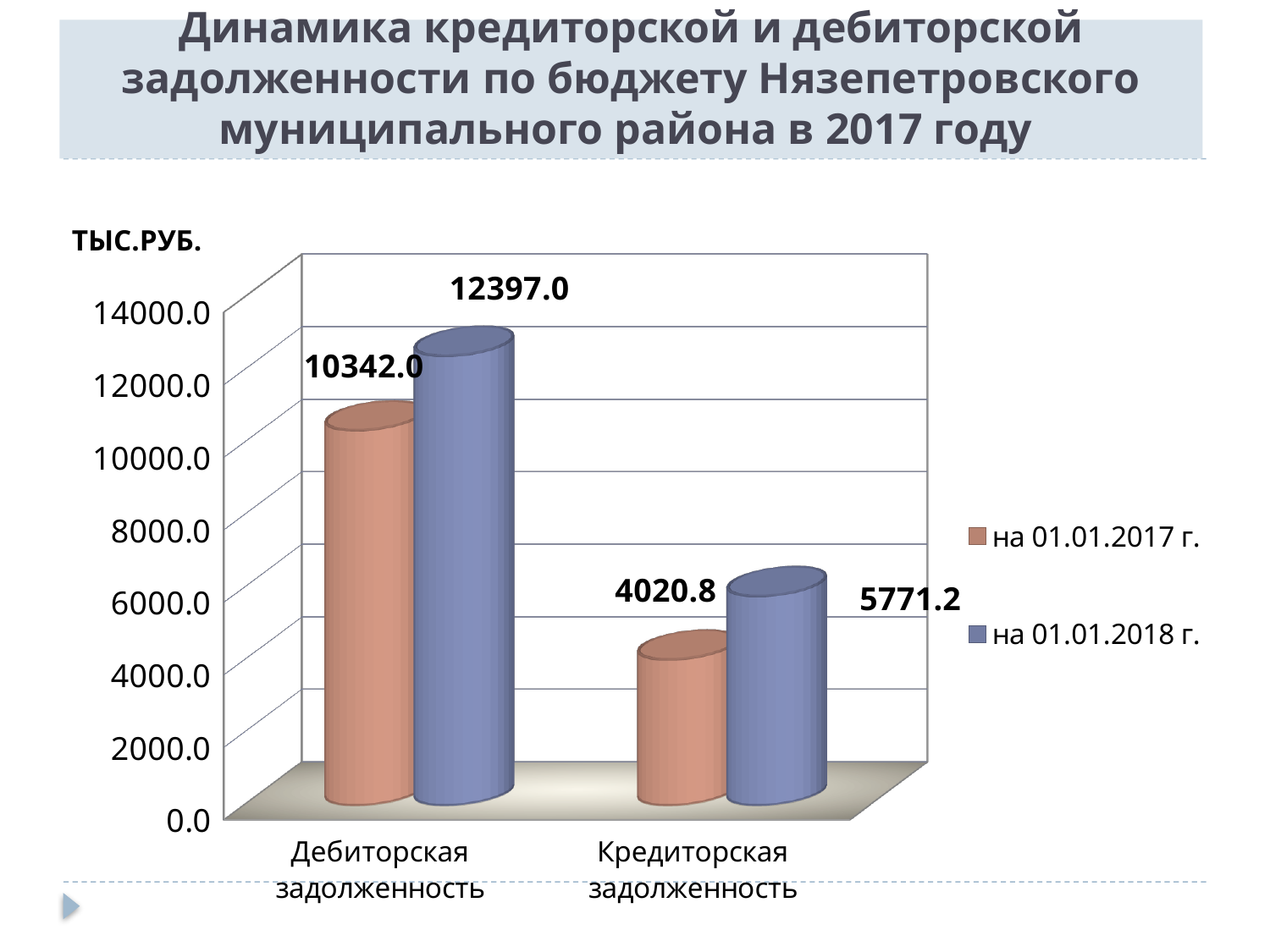
What is the value for Дебиторская задолженность in the series на 01.01.2017 г.? 10342.0 How many categories are shown on the x axis? 2 What is the value for Дебиторская задолженность in the series на 01.01.2018 г.? 12397.0 What is the value for Кредиторская задолженность in the series на 01.01.2018 г.? 5771.2 Which category has the highest value in the series на 01.01.2018 г.? Дебиторская задолженность By how much did Дебиторская задолженность increase from 01.01.2017 to 01.01.2018? 2055.0 What is the value for Кредиторская задолженность in the series на 01.01.2017 г.? 4020.8 What is the difference between the 01.01.2018 and 01.01.2017 values for Кредиторская задолженность? 1750.4 How many series does the legend list? 2 What kind of chart is shown on the slide? Bar chart Which is larger: Кредиторская задолженность на 01.01.2018 г. or Кредиторская задолженность на 01.01.2017 г.? Кредиторская задолженность на 01.01.2018 г. Which category has the lowest value in the series на 01.01.2017 г.? Кредиторская задолженность